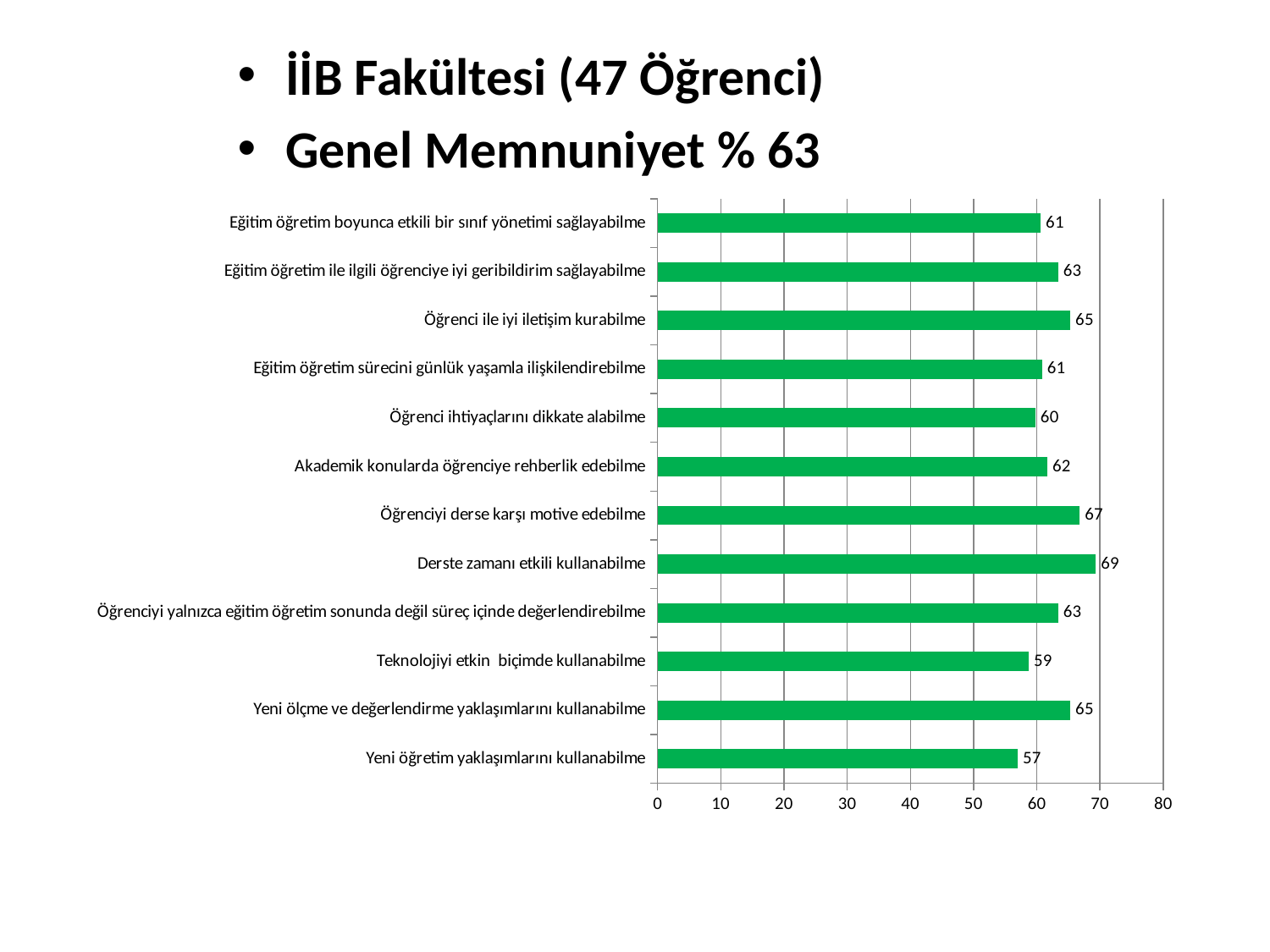
What is the value for "Derste zamanı etkili kullanabilme"? 69 Is the value for "Öğrenci ile iyi iletişim kurabilme" greater or less than 60? greater Which is larger: the value for "Öğrenciyi derse karşı motive edebilme" or the value for "Akademik konularda öğrenciye rehberlik edebilme"? Öğrenciyi derse karşı motive edebilme What is the value for "Öğrenci ihtiyaçlarını dikkate alabilme"? 60 What is the difference between the values for "Derste zamanı etkili kullanabilme" and "Yeni öğretim yaklaşımlarını kullanabilme"? 12 What is the value for "Teknolojiyi etkin biçimde kullanabilme"? 59 Which category has the lowest value? Yeni öğretim yaklaşımlarını kullanabilme What is the value for "Yeni öğretim yaklaşımlarını kullanabilme"? 57 What kind of chart is shown on the slide? bar chart What colour are the bars in the chart? green How many categories are shown in the chart? 12 Which category has the highest value? Derste zamanı etkili kullanabilme